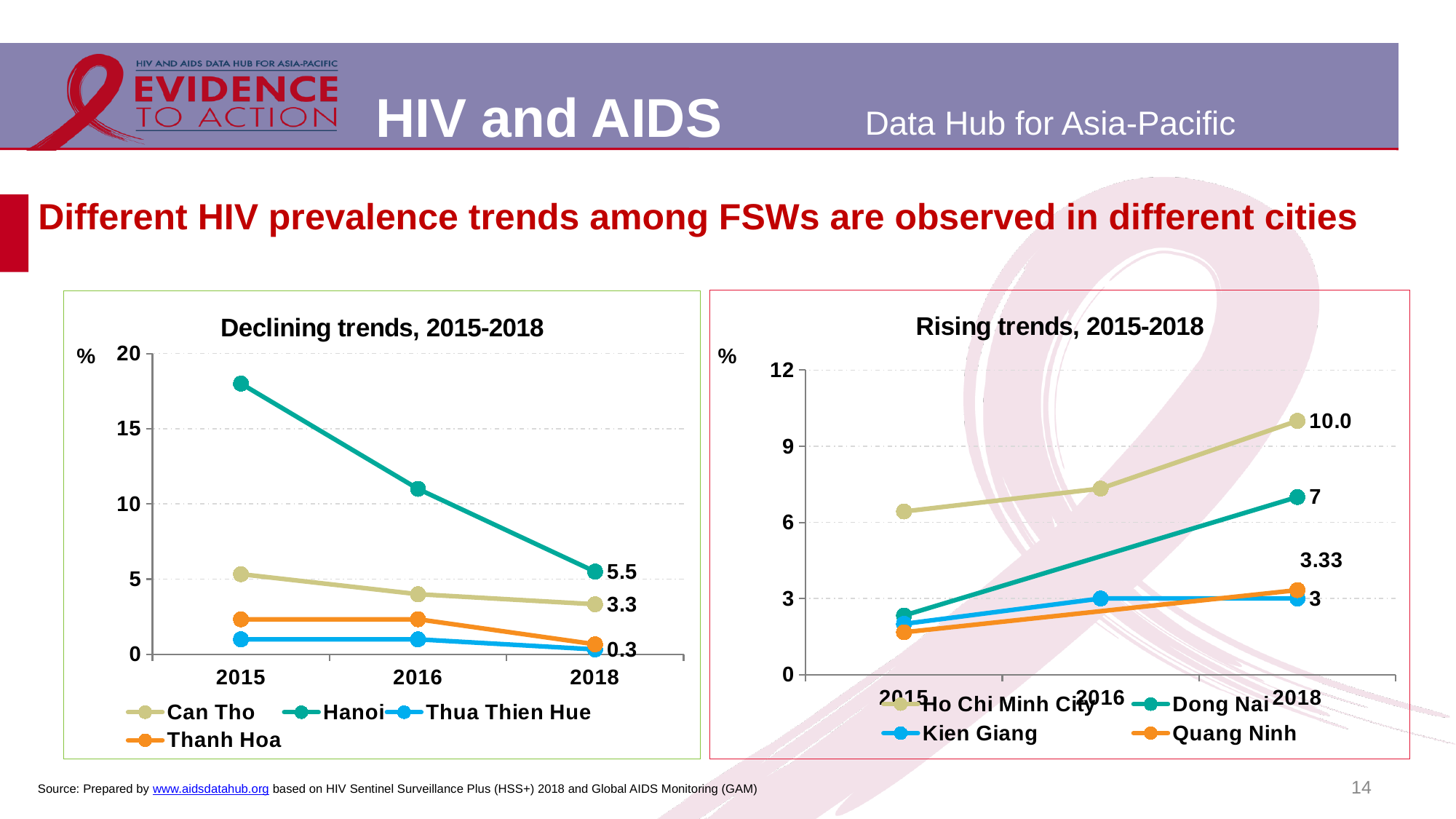
How many series does the legend of the 'Rising trends, 2015-2018' chart list? 4 In the 'Rising trends, 2015-2018' chart, what is the value for Ho Chi Minh City in 2018? 10.0 In the 'Declining trends, 2015-2018' chart, which city has the highest value in 2015? Hanoi In the 'Rising trends, 2015-2018' chart, which is larger in 2018, Ho Chi Minh City or Dong Nai? Ho Chi Minh City In the 'Rising trends, 2015-2018' chart, what is the value for Quang Ninh in 2018? 3.33 In the 'Declining trends, 2015-2018' chart, is the value for Hanoi in 2015 greater or less than 15? greater In the 'Declining trends, 2015-2018' chart, what is the difference between the 2018 values for Hanoi and Can Tho? 2.2 In the 'Declining trends, 2015-2018' chart, what is the value for Can Tho in 2018? 3.3 In the 'Rising trends, 2015-2018' chart, what is the value for Dong Nai in 2018? 7 In the 'Declining trends, 2015-2018' chart, does the value for Hanoi rise or fall from 2015 to 2018? fall In the 'Declining trends, 2015-2018' chart, what is the value for Hanoi in 2018? 5.5 What kind of chart is the 'Declining trends, 2015-2018' chart? line chart